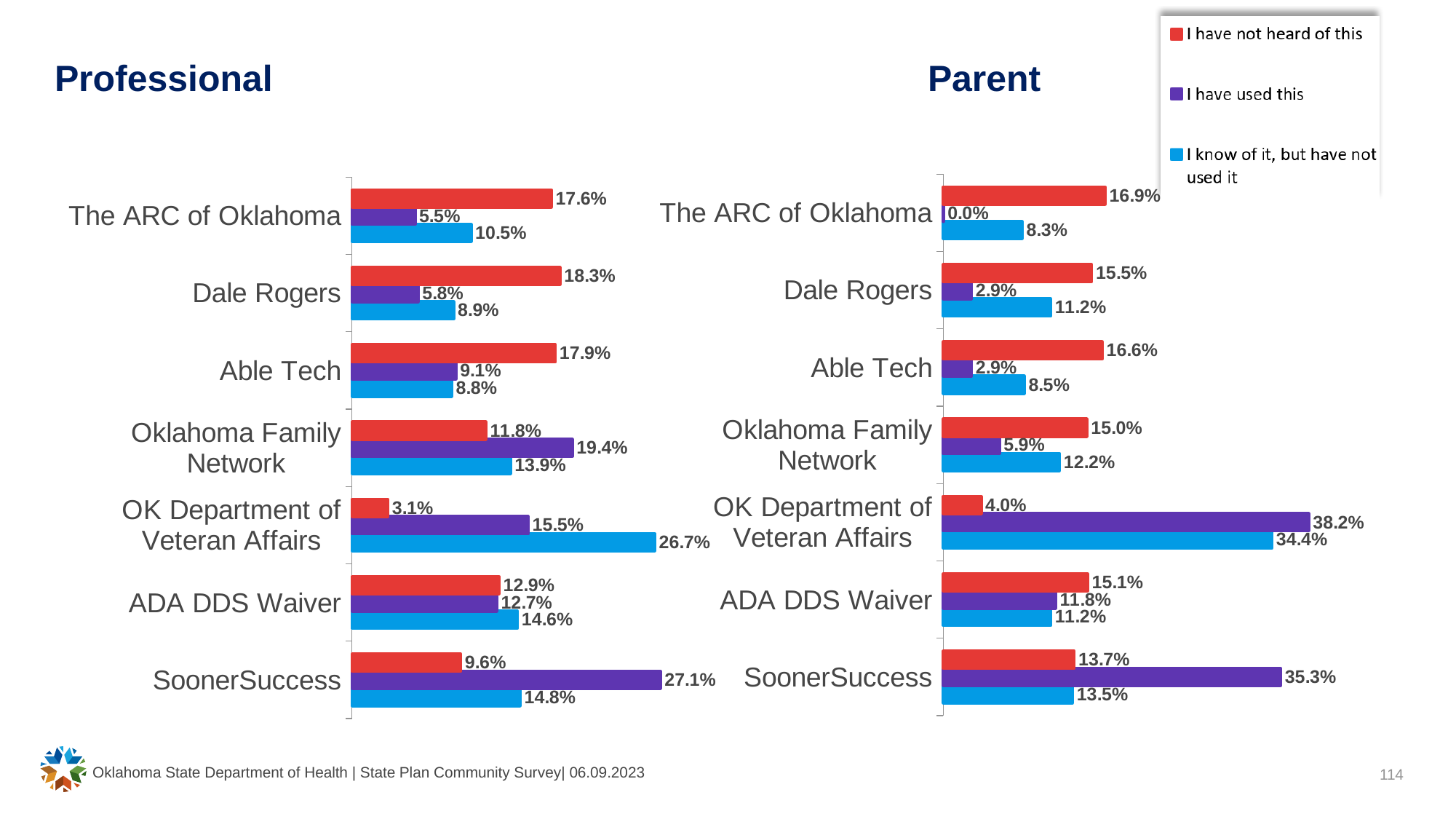
Which colour represents 'I have used this' in the legend? Purple In the Professional chart, which category has the highest value for 'I know of it, but have not used it'? OK Department of Veteran Affairs How many series does the legend list? 3 In the Parent chart, what is the value for 'I have not heard of this' for The ARC of Oklahoma? 16.9% In the Parent chart, what is the value for 'I know of it, but have not used it' for OK Department of Veteran Affairs? 34.4% In the Parent chart, which category has the lowest value for 'I have used this'? The ARC of Oklahoma In the Parent chart, which is larger for OK Department of Veteran Affairs: 'I have used this' or 'I know of it, but have not used it'? I have used this What kind of chart is the Parent chart? Bar chart In the Professional chart, what is the difference between 'I have used this' and 'I have not heard of this' for SoonerSuccess? 17.5% How many categories are shown in the Professional chart? 7 In the Professional chart, what is the value for 'I have used this' for SoonerSuccess? 27.1% In the Professional chart, what is the value for 'I have not heard of this' for Dale Rogers? 18.3%